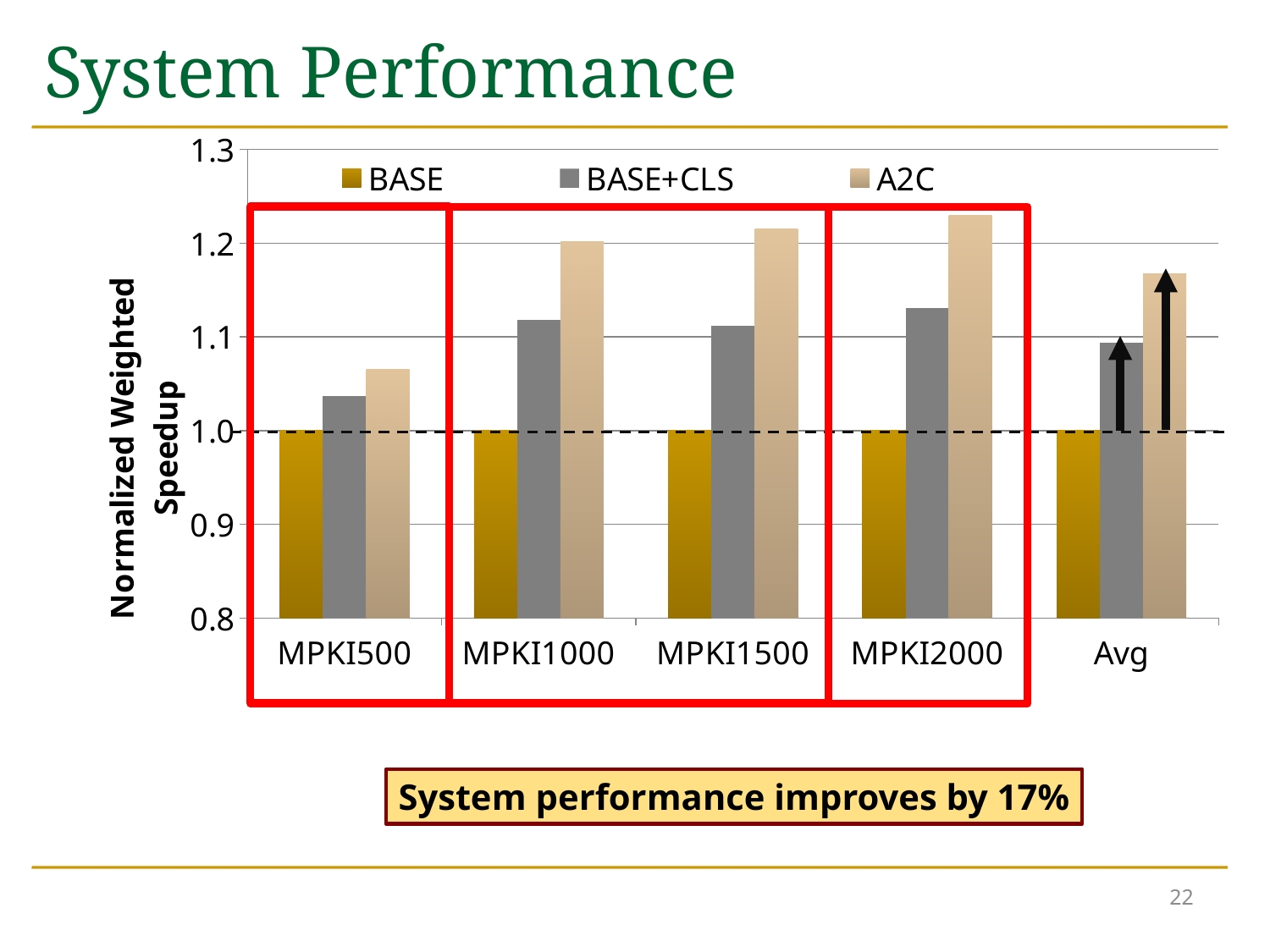
Is the A2C value for MPKI2000 greater or less than 1.2? greater For MPKI1500, which is larger: the BASE+CLS bar or the A2C bar? A2C What is the Normalized Weighted Speedup of BASE for MPKI1000? 1.0 How many categories are shown on the x axis? 5 Do the A2C values rise or fall from MPKI500 to MPKI2000? rise What kind of chart is shown on the slide? bar chart Is the A2C value for Avg greater or less than 1.2? less Is the A2C value for MPKI500 greater or less than 1.1? less Which category has the lowest A2C bar? MPKI500 How many series does the legend list? 3 Which category has the highest A2C bar? MPKI2000